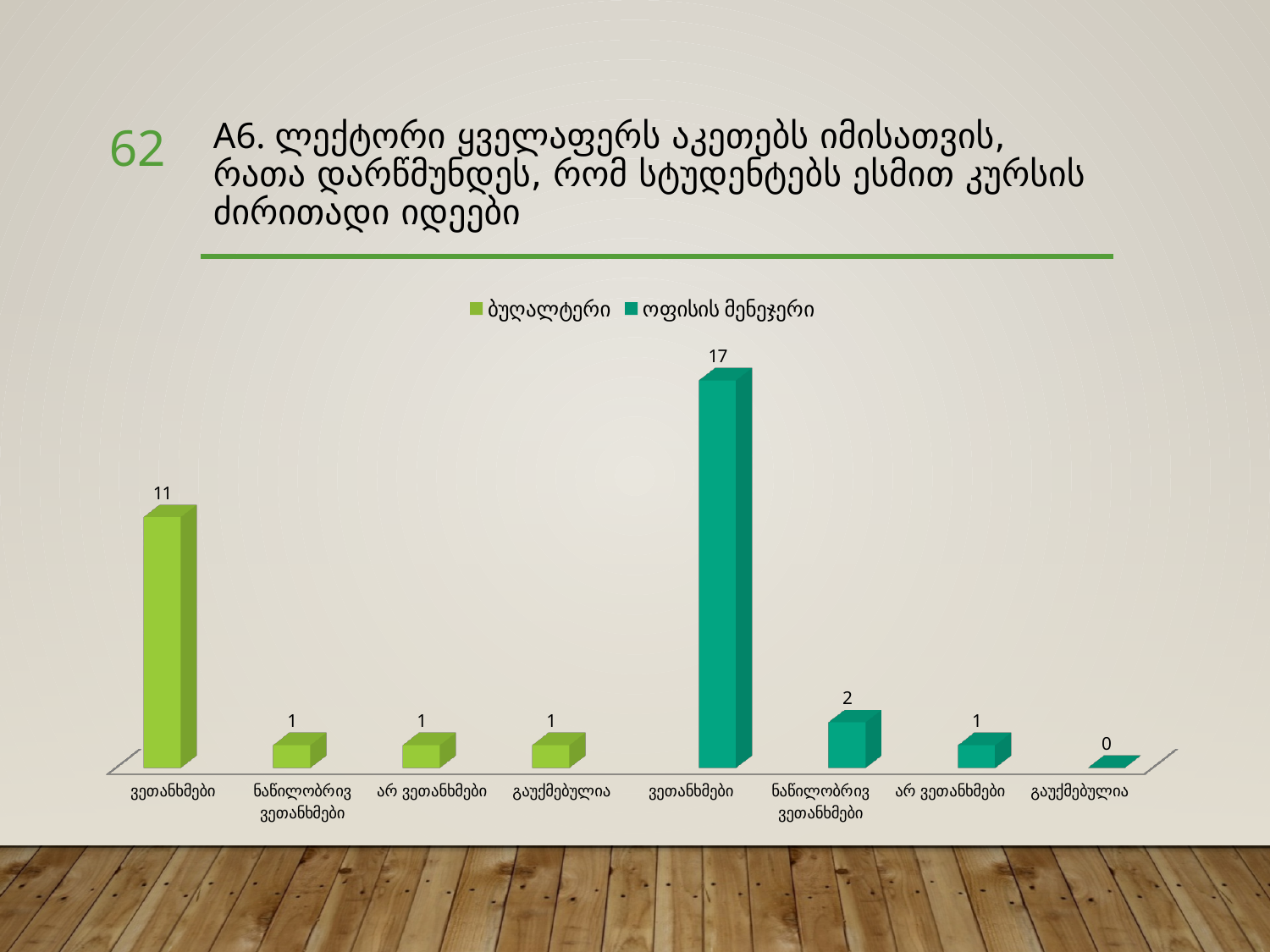
Which is larger: ნაწილობრივ ვეთანხმები for ბუღალტერი or for ოფისის მენეჯერი? ოფისის მენეჯერი What is the value for ნაწილობრივ ვეთანხმები in the ოფისის მენეჯერი series? 2 What is the value for გაუქმებულია in the ოფისის მენეჯერი series? 0 How many series does the legend list? 2 Which bar has the highest value on the chart? ვეთანხმები (ოფისის მენეჯერი) Which series is shown in light green in the legend? ბუღალტერი What is the value for არ ვეთანხმები in the ბუღალტერი series? 1 What is the value for ვეთანხმები in the ბუღალტერი series? 11 What is the difference between the ვეთანხმები values for ოფისის მენეჯერი and ბუღალტერი? 6 Which category has the lowest value in the ოფისის მენეჯერი series? გაუქმებულია What kind of chart is shown on the slide? Bar chart What is the value for ვეთანხმები in the ოფისის მენეჯერი series? 17